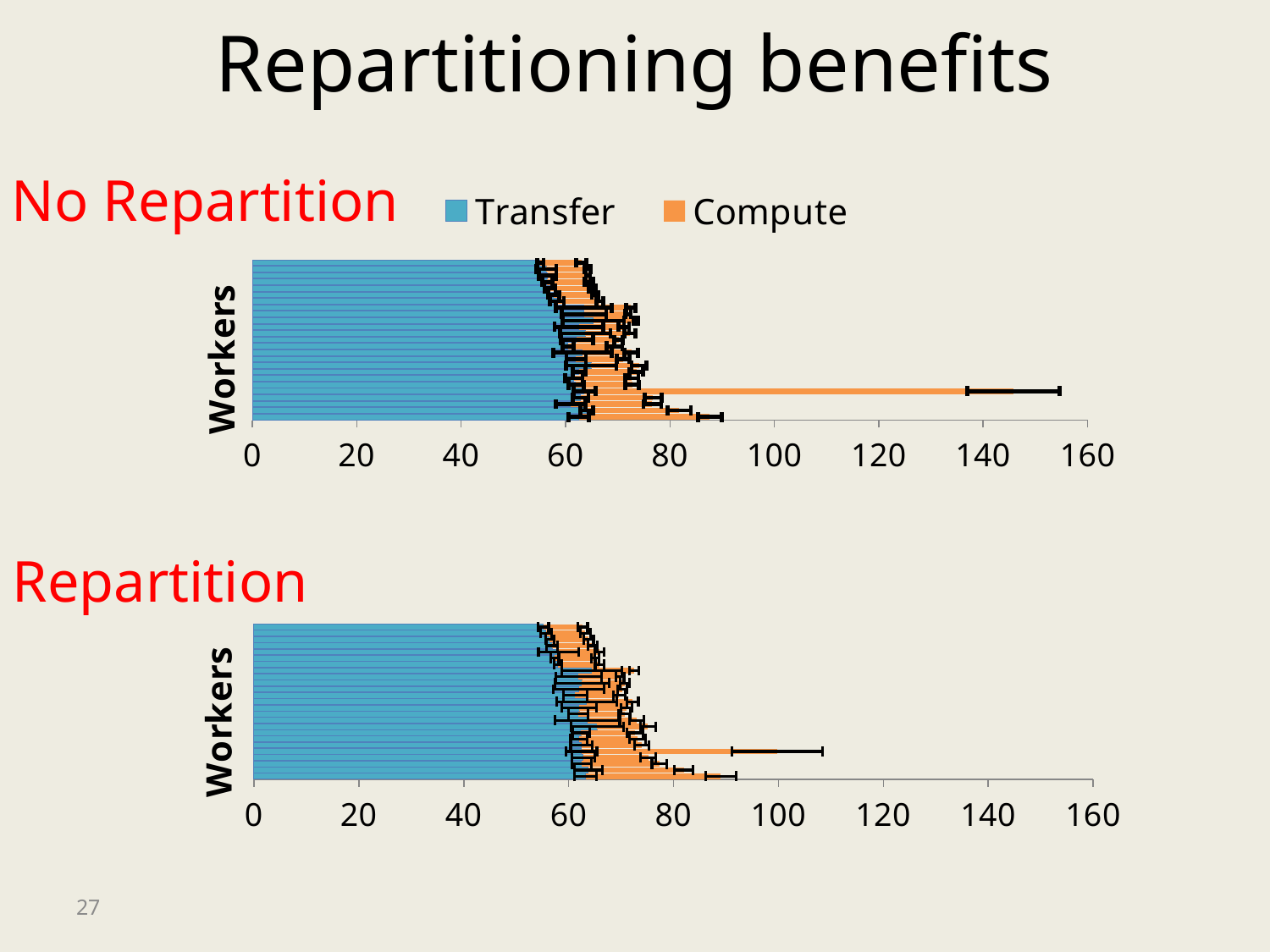
In the "No Repartition" chart, is the Transfer portion of the bars greater or less than 40? greater In the "No Repartition" chart, which series, Transfer or Compute, makes up the larger part of a typical bar? Transfer In the "No Repartition" chart, is the total length of the longest bar greater or less than 120? greater What kind of chart is the "No Repartition" chart? stacked bar chart What is the highest tick value shown on the x axis of the "Repartition" chart? 160 Which chart has the longer longest bar, "No Repartition" or "Repartition"? No Repartition What is the label on the vertical axis of the "Repartition" chart? Workers What are the two series named in the legend? Transfer and Compute How many series does the legend list for the charts on this slide? 2